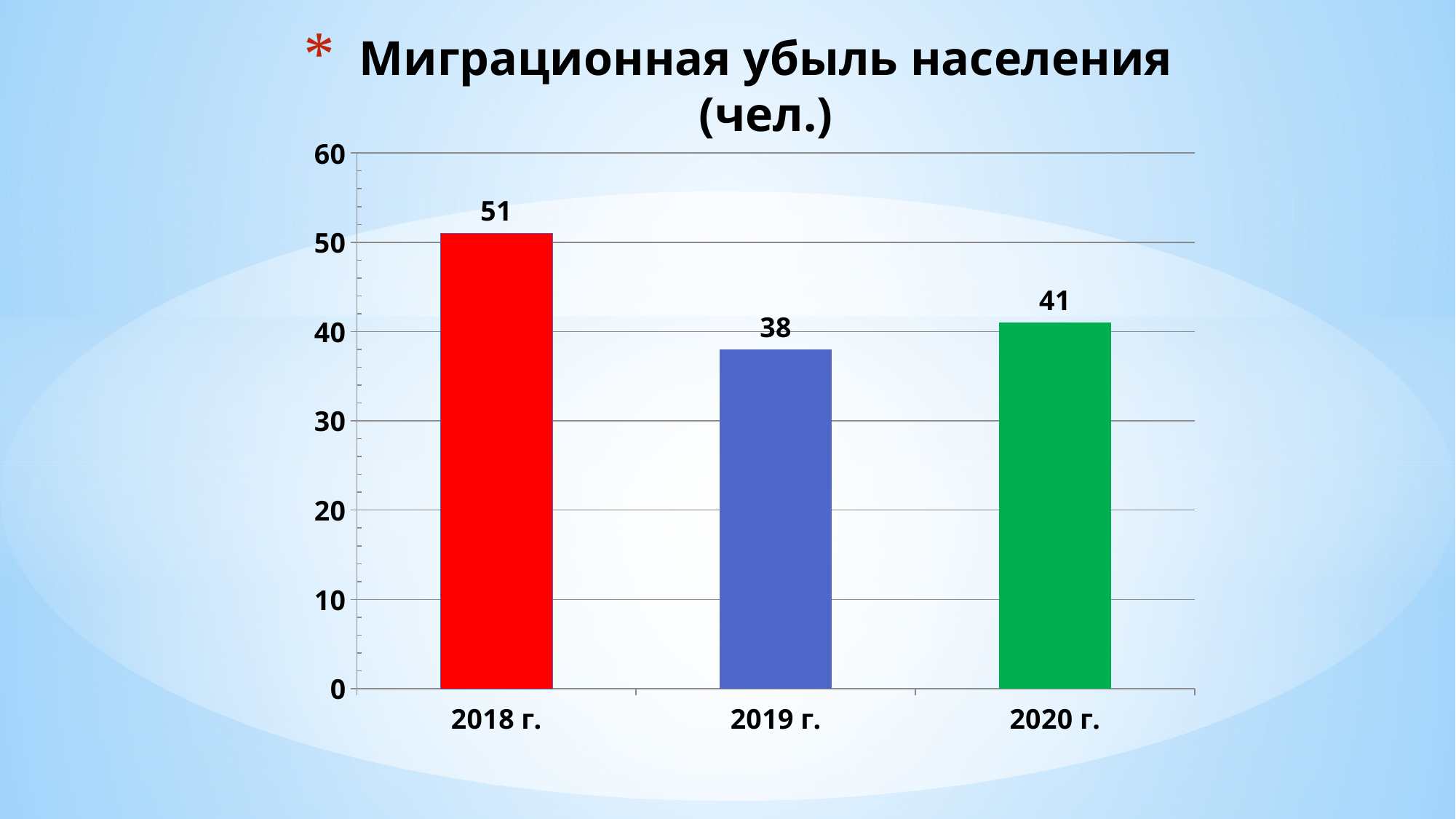
Is the value for 2019 г. greater or less than 40? less What is the value for 2020 г.? 41 What is the difference between the values for 2018 г. and 2019 г.? 13 Which year has the lowest value? 2019 г. What is the value for 2018 г.? 51 What is the difference between the values for 2020 г. and 2019 г.? 3 What is the value for 2019 г.? 38 What kind of chart is shown on the slide? bar chart Which is larger, the value for 2018 г. or the value for 2020 г.? 2018 г. What is the title of the chart? Миграционная убыль населения (чел.) Which year has the highest value? 2018 г. How many years are shown on the chart? 3